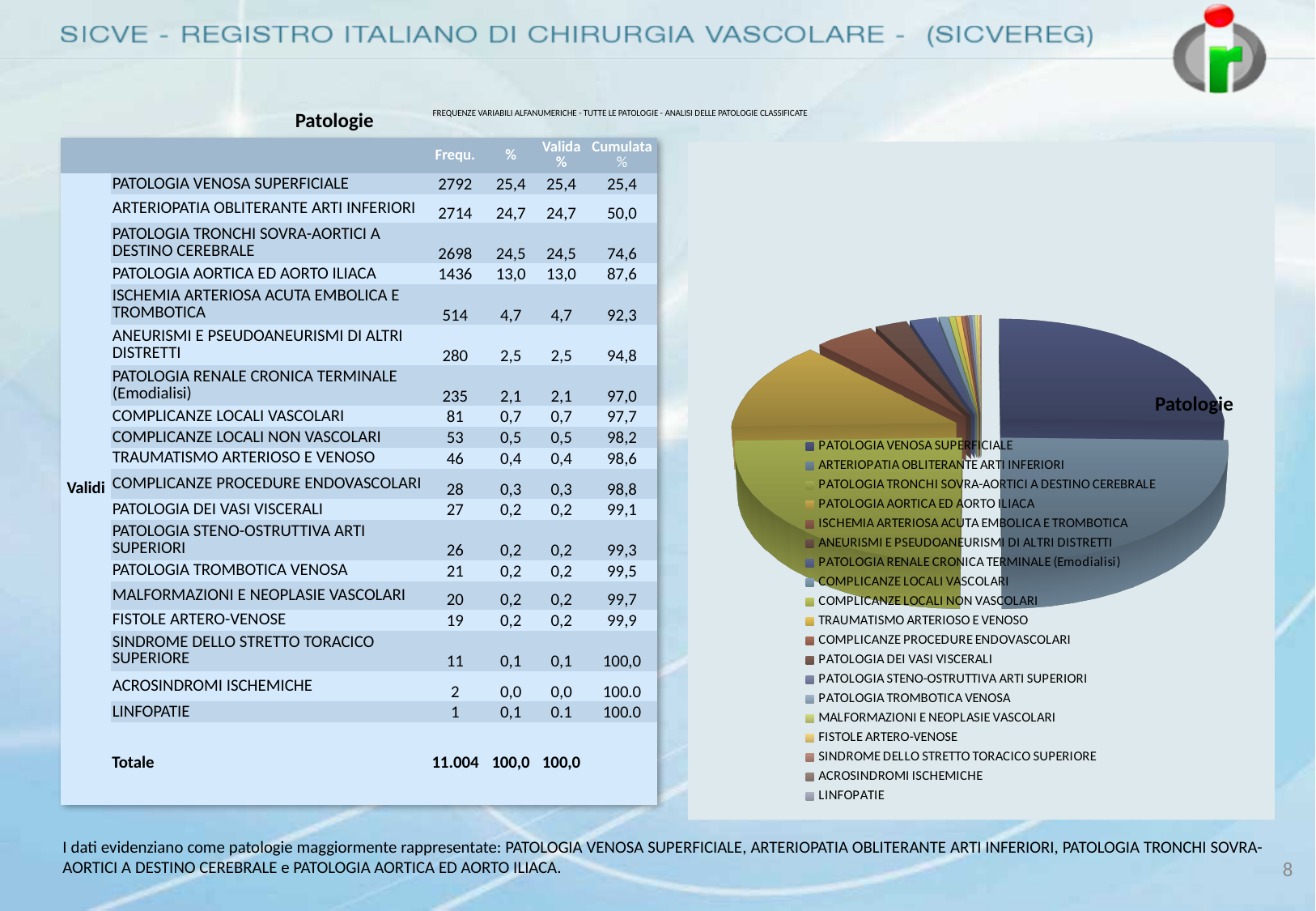
In the pie chart, which slice is larger: PATOLOGIA TRONCHI SOVRA-AORTICI A DESTINO CEREBRALE or PATOLOGIA RENALE CRONICA TERMINALE (Emodialisi)? PATOLOGIA TRONCHI SOVRA-AORTICI A DESTINO CEREBRALE In the pie chart, which slice is larger: PATOLOGIA AORTICA ED AORTO ILIACA or ANEURISMI E PSEUDOANEURISMI DI ALTRI DISTRETTI? PATOLOGIA AORTICA ED AORTO ILIACA How many categories does the legend of the pie chart list? 19 What kind of chart is shown on the right side of the slide? pie chart Which category is listed first in the pie chart's legend? PATOLOGIA VENOSA SUPERFICIALE In the pie chart, which slice is larger: PATOLOGIA VENOSA SUPERFICIALE or PATOLOGIA AORTICA ED AORTO ILIACA? PATOLOGIA VENOSA SUPERFICIALE What is the title of the pie chart? Patologie